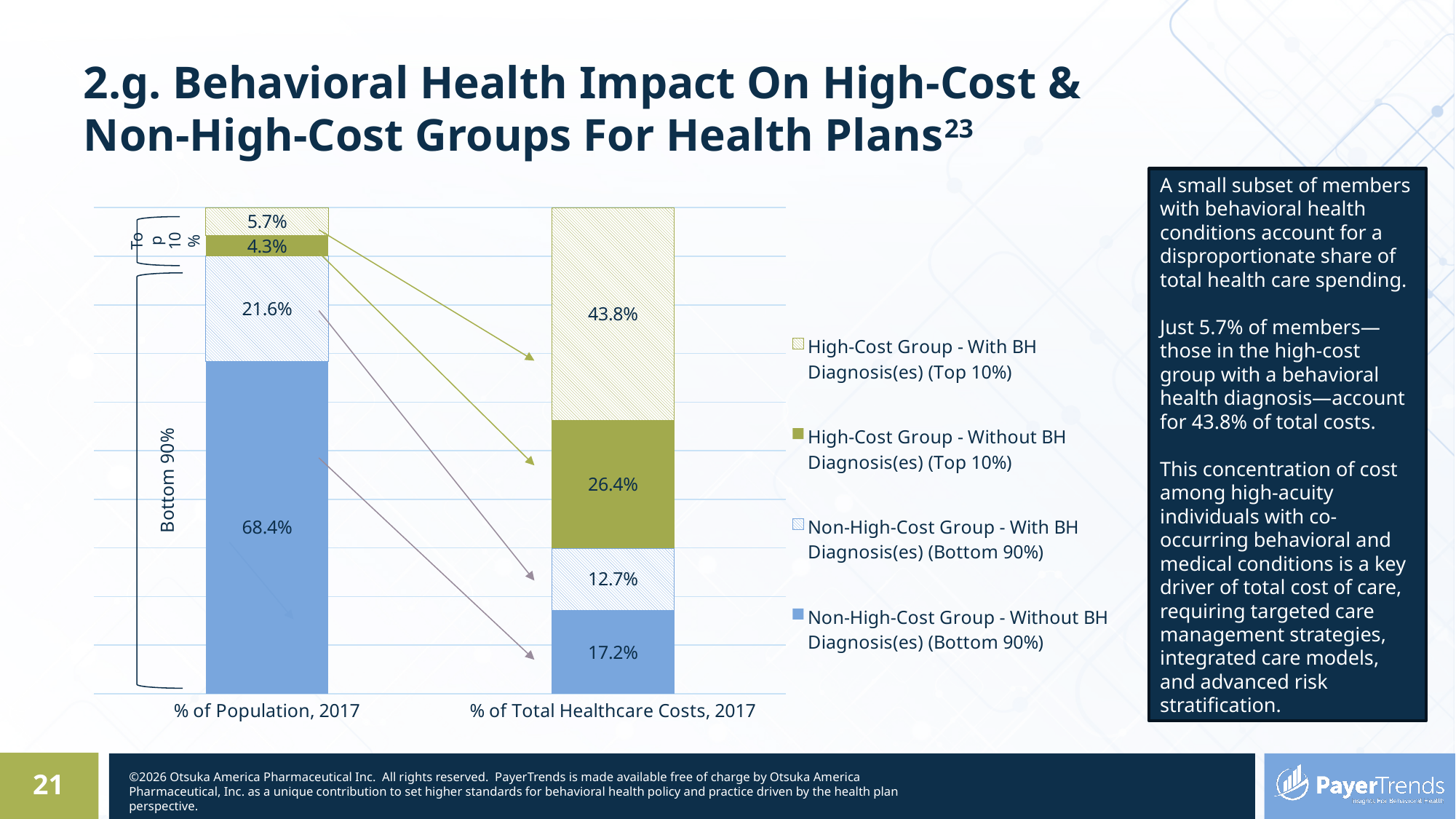
What is the value for Non-High-Cost Group - Without BH Diagnosis(es) (Bottom 90%) in the % of Population, 2017 bar? 68.4% What is the value for High-Cost Group - With BH Diagnosis(es) (Top 10%) in the % of Population, 2017 bar? 5.7% Which segment is the largest in the % of Total Healthcare Costs, 2017 bar? High-Cost Group - With BH Diagnosis(es) (Top 10%) How many series does the legend list? 4 What is the combined share of total healthcare costs for the two Top 10% (high-cost) segments? 70.2% How many bars (categories) are plotted on the x axis? 2 What kind of chart is shown on the slide? Stacked bar chart What is the difference between the High-Cost Group - Without BH Diagnosis(es) (Top 10%) share of total healthcare costs and its share of population? 22.1% What is the value for Non-High-Cost Group - With BH Diagnosis(es) (Bottom 90%) in the % of Total Healthcare Costs, 2017 bar? 12.7% Which segment is the smallest in the % of Population, 2017 bar? High-Cost Group - Without BH Diagnosis(es) (Top 10%) What is the value for High-Cost Group - With BH Diagnosis(es) (Top 10%) in the % of Total Healthcare Costs, 2017 bar? 43.8% Which is larger: the Non-High-Cost Group - Without BH Diagnosis(es) (Bottom 90%) share of population or its share of total healthcare costs? Share of population